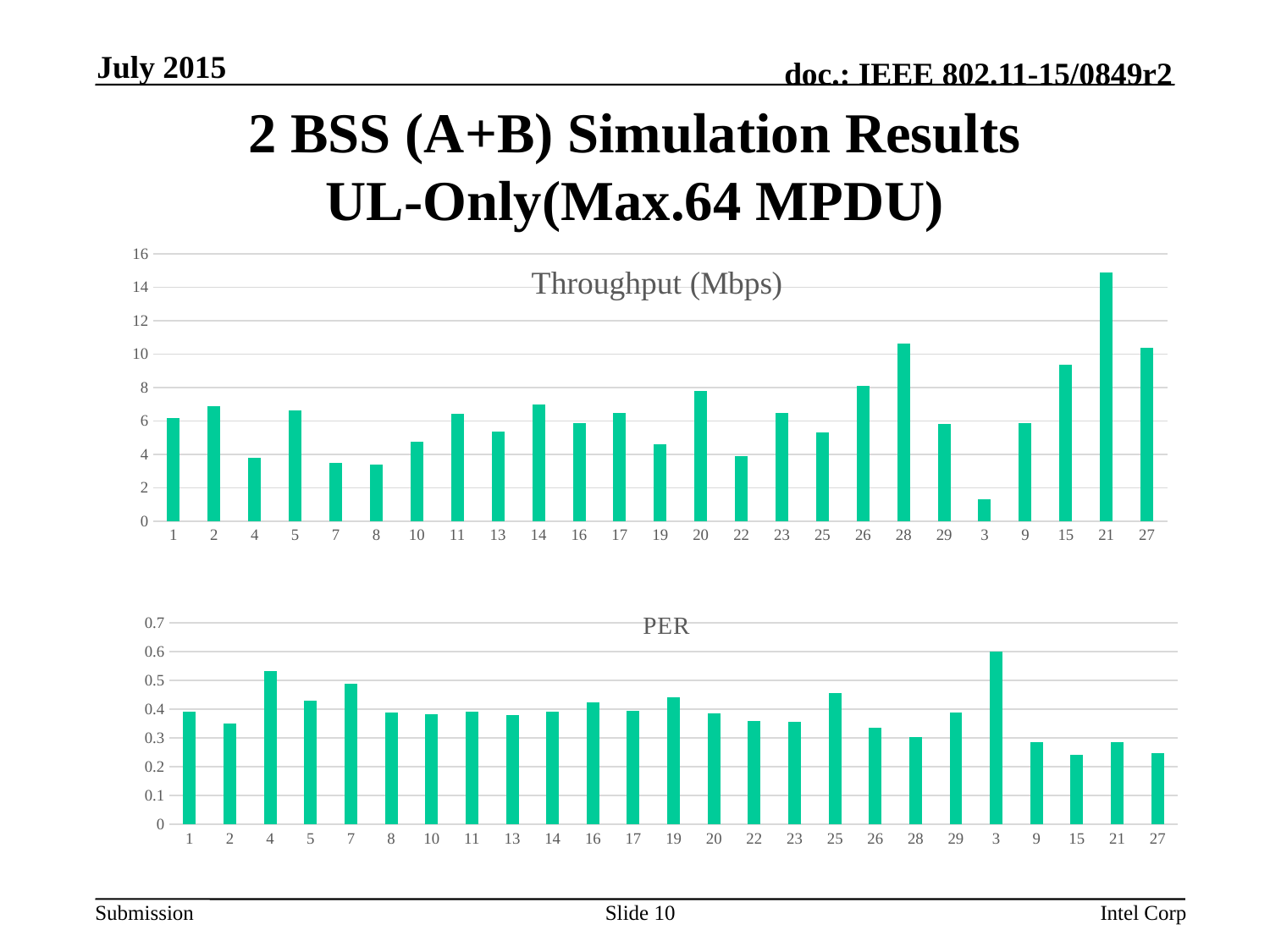
What is the title of the top chart on the slide? Throughput (Mbps) In the Throughput (Mbps) chart, is the value for category 3 greater or less than 2? less How many categories are plotted on the PER chart? 25 In the Throughput (Mbps) chart, which has the larger value, category 2 or category 4? 2 In the Throughput (Mbps) chart, which category has the highest throughput? 21 What kind of chart is the Throughput (Mbps) chart? bar chart In the Throughput (Mbps) chart, is the value for category 21 greater or less than 14? greater In the PER chart, is the value for category 4 greater or less than 0.5? greater In the PER chart, which category has the highest PER? 3 In the Throughput (Mbps) chart, which category has the lowest throughput? 3